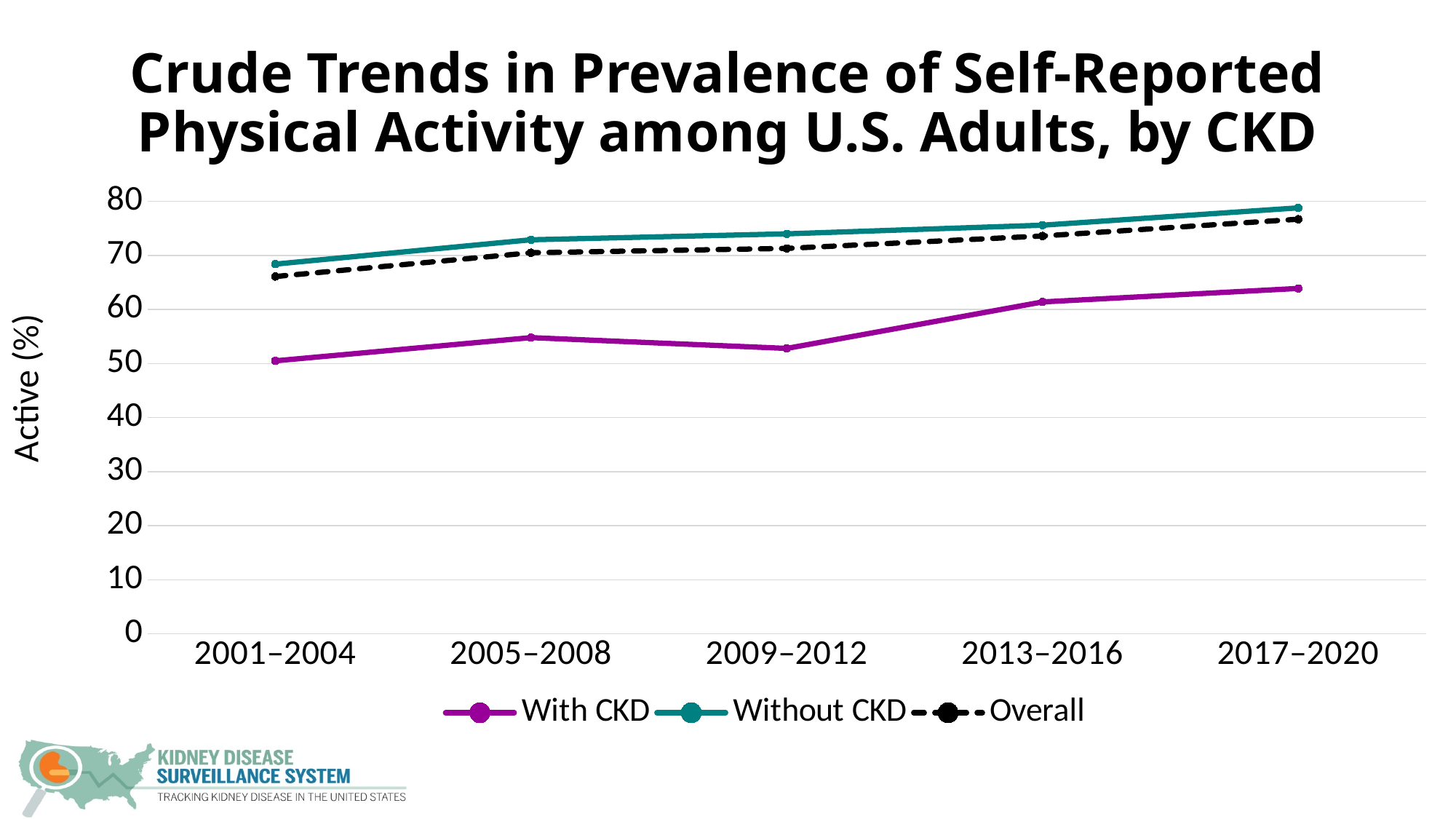
Is the value for With CKD in 2017–2020 greater or less than 60? greater How many series does the legend list? 3 In which period is the With CKD value lowest? 2001–2004 In 2013–2016, which series has the larger value, With CKD or Without CKD? Without CKD Is the value for With CKD in 2001–2004 greater or less than 60? less Is the value for Overall in 2001–2004 greater or less than 70? less What is the label of the y axis? Active (%) What kind of chart is shown on the slide? line chart Does the Without CKD series rise or fall from 2001–2004 to 2017–2020? rise In which period is the With CKD value highest? 2017–2020 How many time periods are shown on the x axis? 5